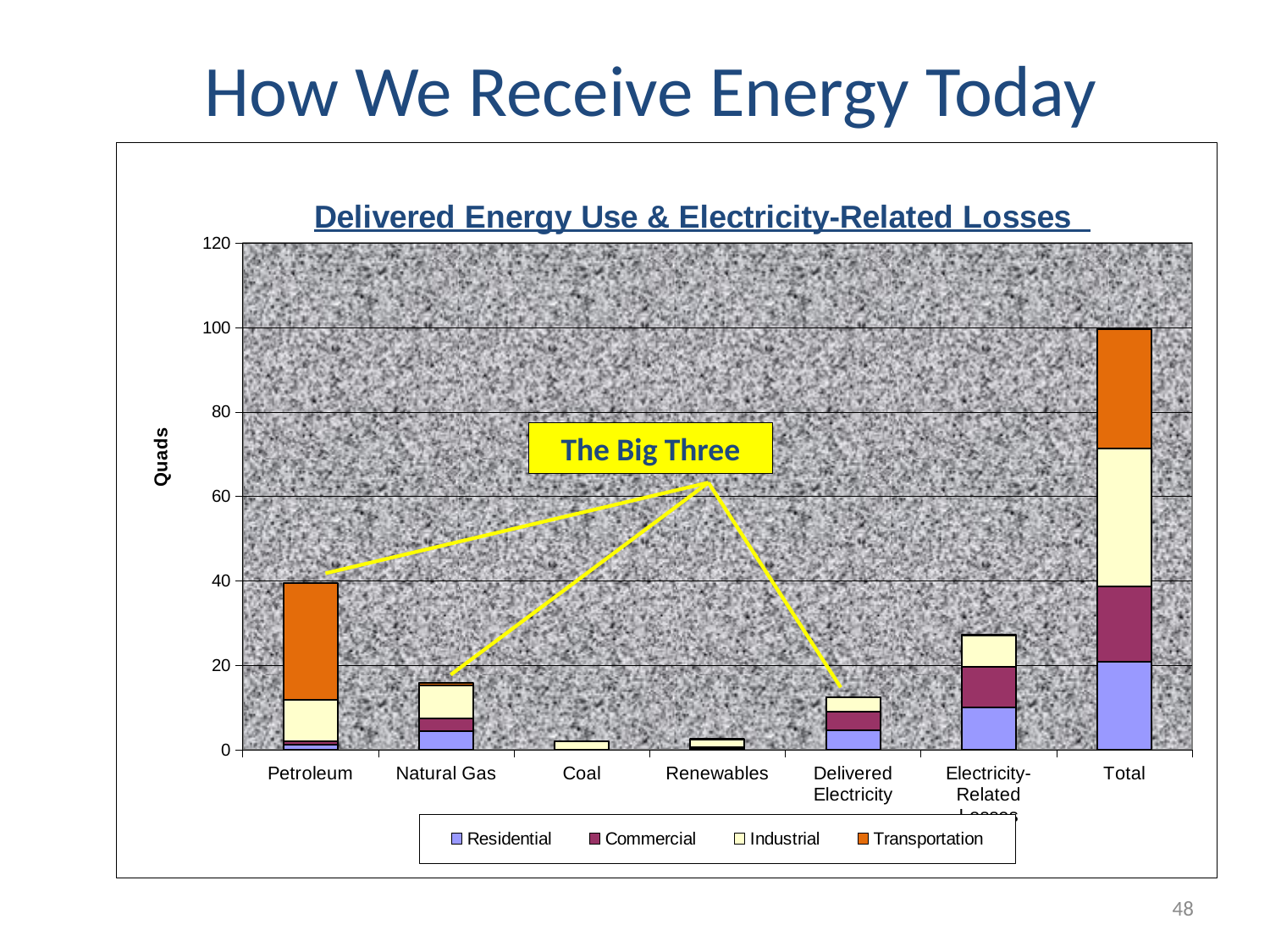
Which has the larger stacked bar, Petroleum or Natural Gas? Petroleum What is the label on the vertical axis of the chart? Quads What is the title of the chart? Delivered Energy Use & Electricity-Related Losses Is the total value for Petroleum greater or less than 20? greater What kind of chart is shown on the slide? Stacked bar chart Is the total value for the Total bar greater or less than 80? greater Is the total value for Electricity-Related Losses greater or less than 20? greater How many series does the legend list? 4 Which has the larger stacked bar, Delivered Electricity or Electricity-Related Losses? Electricity-Related Losses Which category has the tallest stacked bar? Total How many categories are shown along the x axis? 7